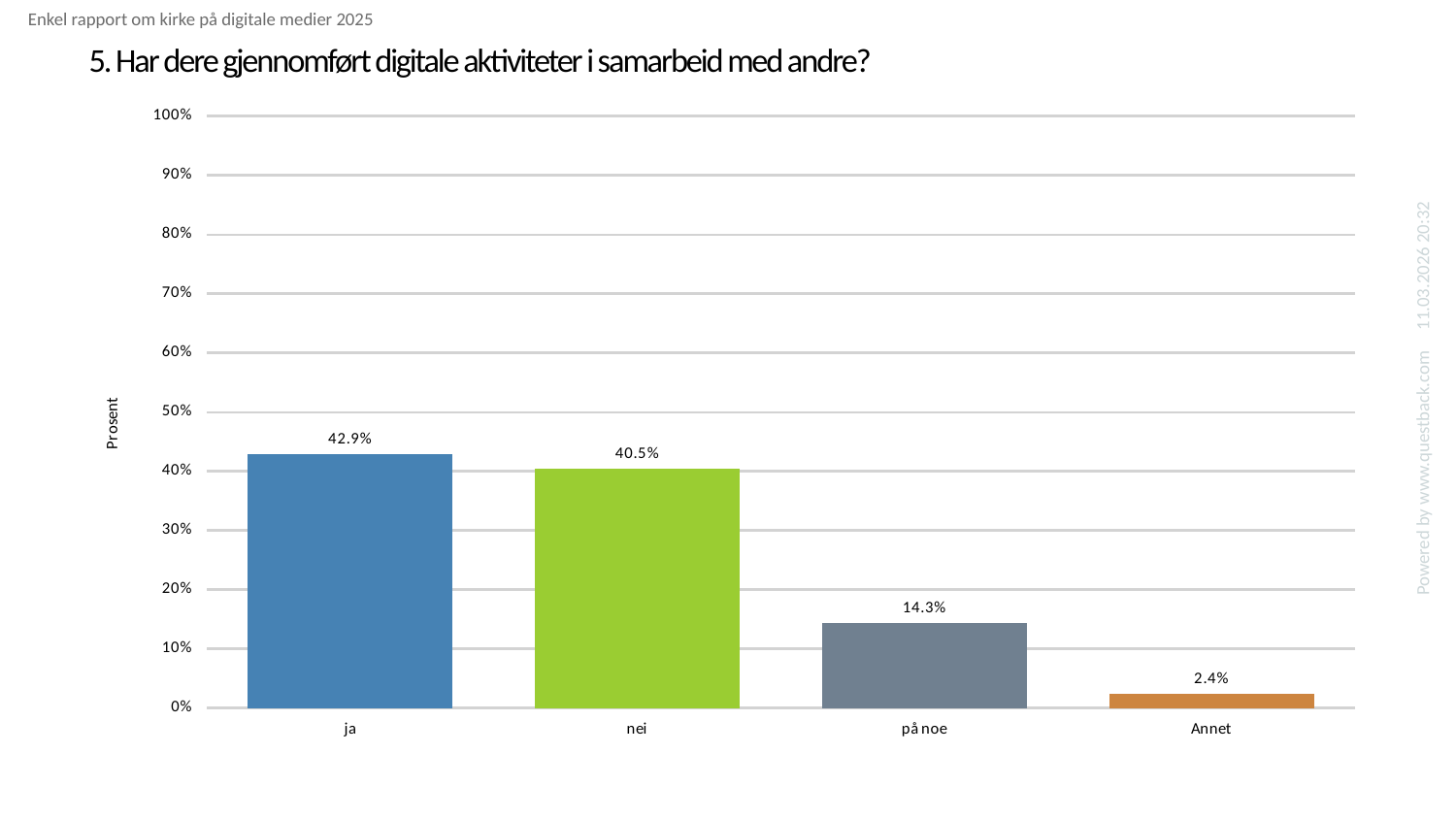
What is the value for "Annet"? 2.4% What is the label of the y axis? Prosent What is the difference between the values for "nei" and "på noe"? 26.2% What is the value for "ja"? 42.9% What is the value for "på noe"? 14.3% What is the value for "nei"? 40.5% What is the difference between the values for "ja" and "nei"? 2.4% Which category has the lowest value? Annet What kind of chart is shown on the slide? bar chart Which is larger, the value for "på noe" or the value for "Annet"? på noe Which category has the highest value? ja How many categories are shown on the x axis? 4